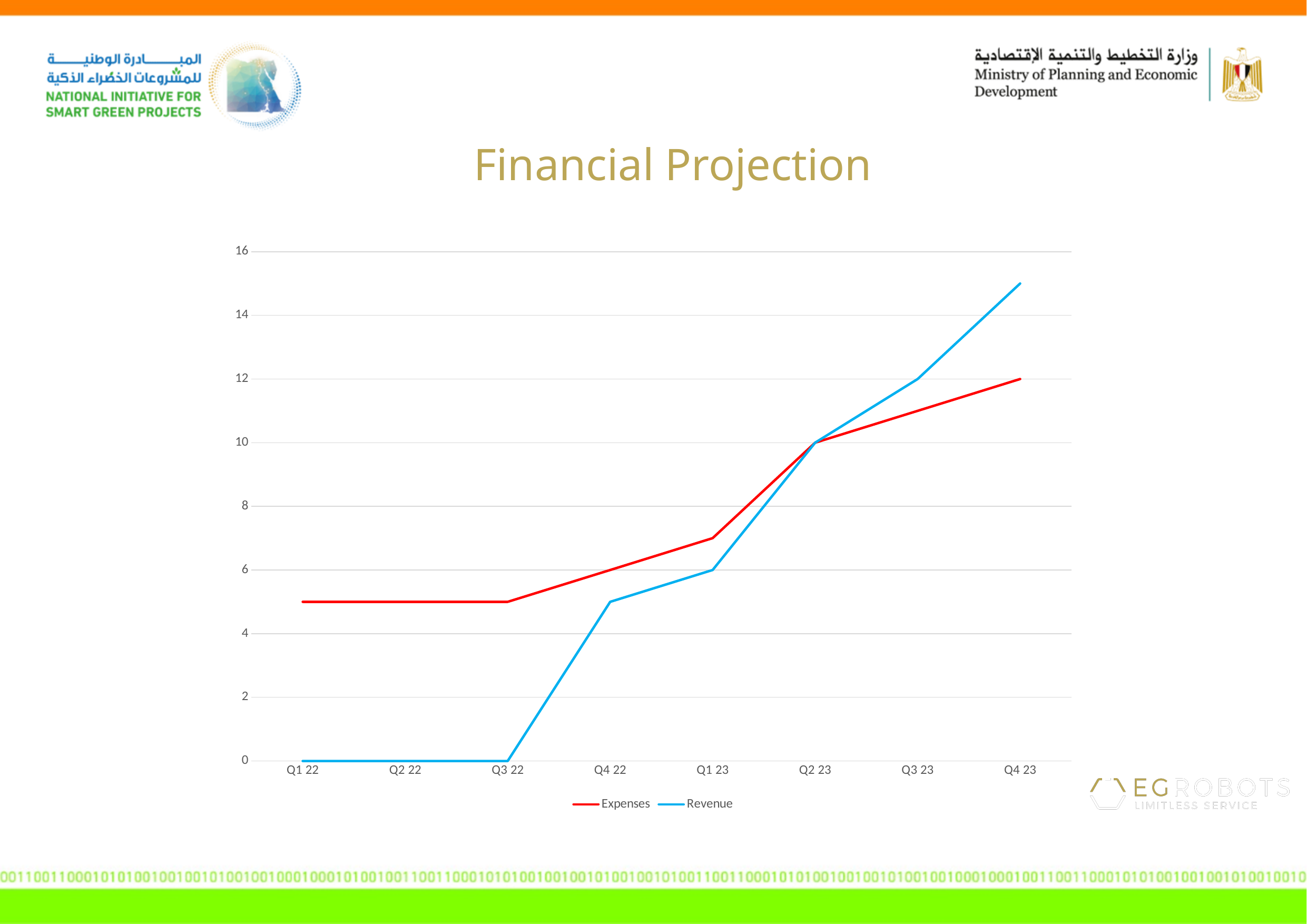
Is the Expenses value for Q1 22 greater or less than 4? greater What is the Revenue value for Q3 23? 12 What is the Revenue value for Q1 22? 0 Is the Revenue value for Q4 23 greater or less than 14? greater In which quarter is Revenue highest? Q4 23 How many series does the legend list? 2 What is the Expenses value for Q4 22? 6 How many quarters are plotted along the x axis? 8 What is the Expenses value for Q4 23? 12 What kind of chart is shown on the slide? line chart What is the difference between Revenue in Q3 23 and Revenue in Q1 23? 6 In Q4 23, which is larger, Revenue or Expenses? Revenue